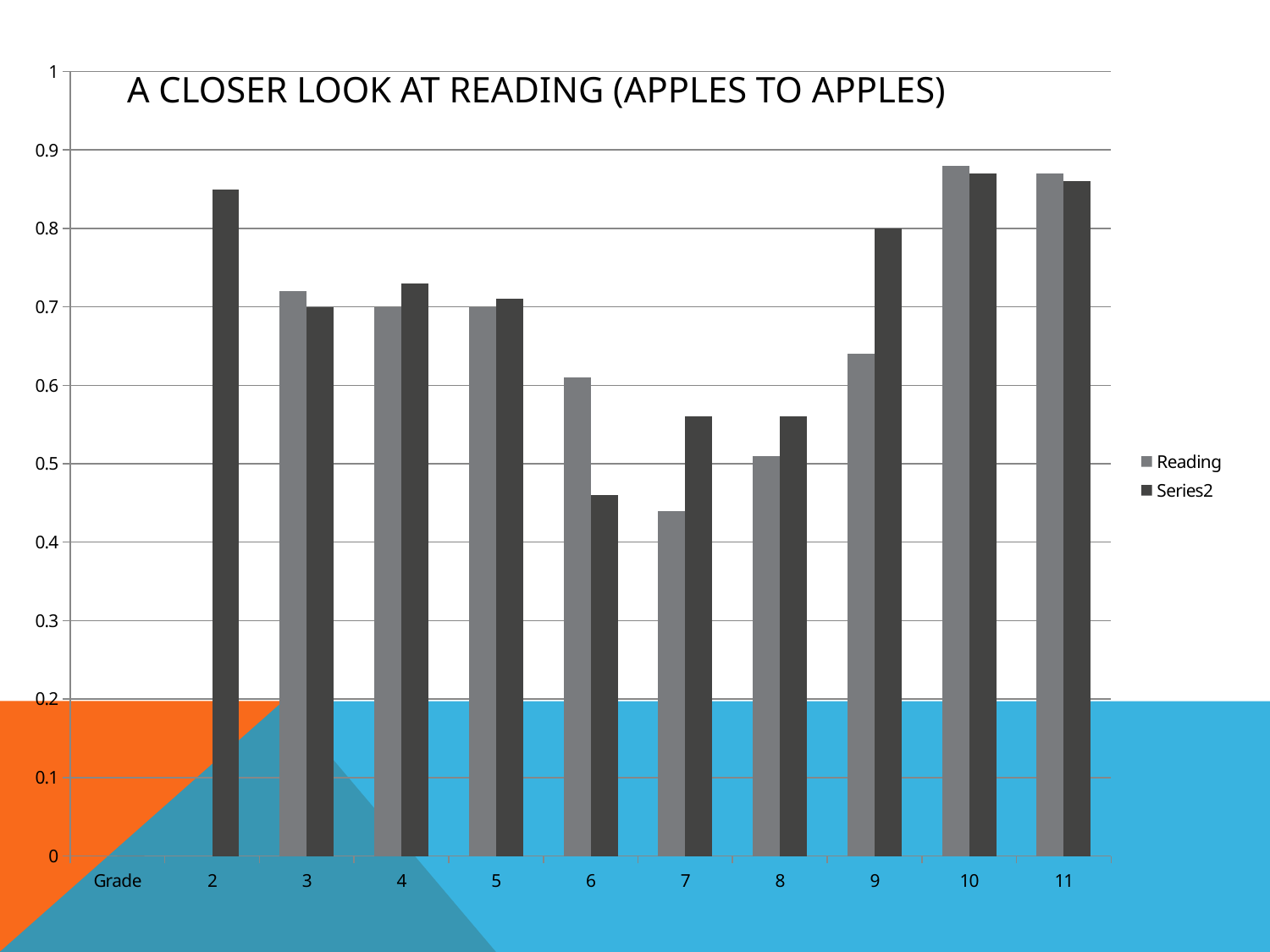
Is the Reading value for grade 7 greater or less than 0.5? less What type of chart is shown on the slide? bar chart At grade 6, which series has the larger value, Reading or Series2? Reading Which grade has the lowest Reading value? 7 What is the Series2 value for grade 3? 0.7 Is the Series2 value for grade 2 greater or less than 0.8? greater How many categories are labelled on the x axis? 11 How many series does the legend list? 2 What is the Series2 value for grade 9? 0.8 At grade 9, which series has the larger value, Reading or Series2? Series2 Which grade has the lowest Series2 value? 6 What is the title of the chart? A CLOSER LOOK AT READING (APPLES TO APPLES)